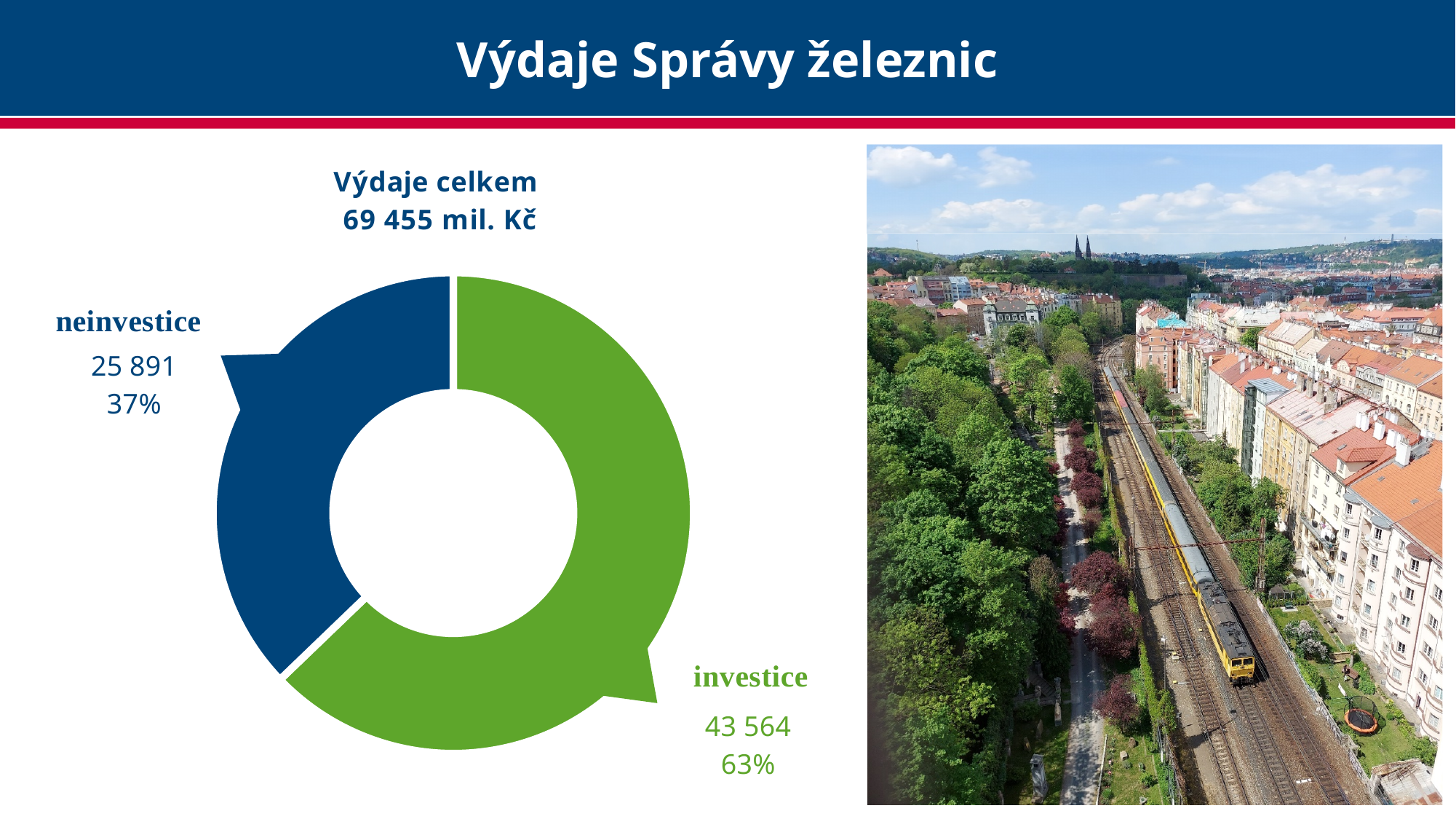
What colour is the investice segment? green What total expenditure is stated above the chart? 69 455 mil. Kč What share of the chart does investice represent? 63% Which is larger, investice or neinvestice? investice Which category has the smallest value? neinvestice What is the difference between the values for investice and neinvestice? 17 673 How many categories does the chart show? 2 What share of the chart does neinvestice represent? 37% What is the value for investice? 43 564 What is the value for neinvestice? 25 891 Which category has the largest value? investice What kind of chart is shown on the slide? doughnut chart